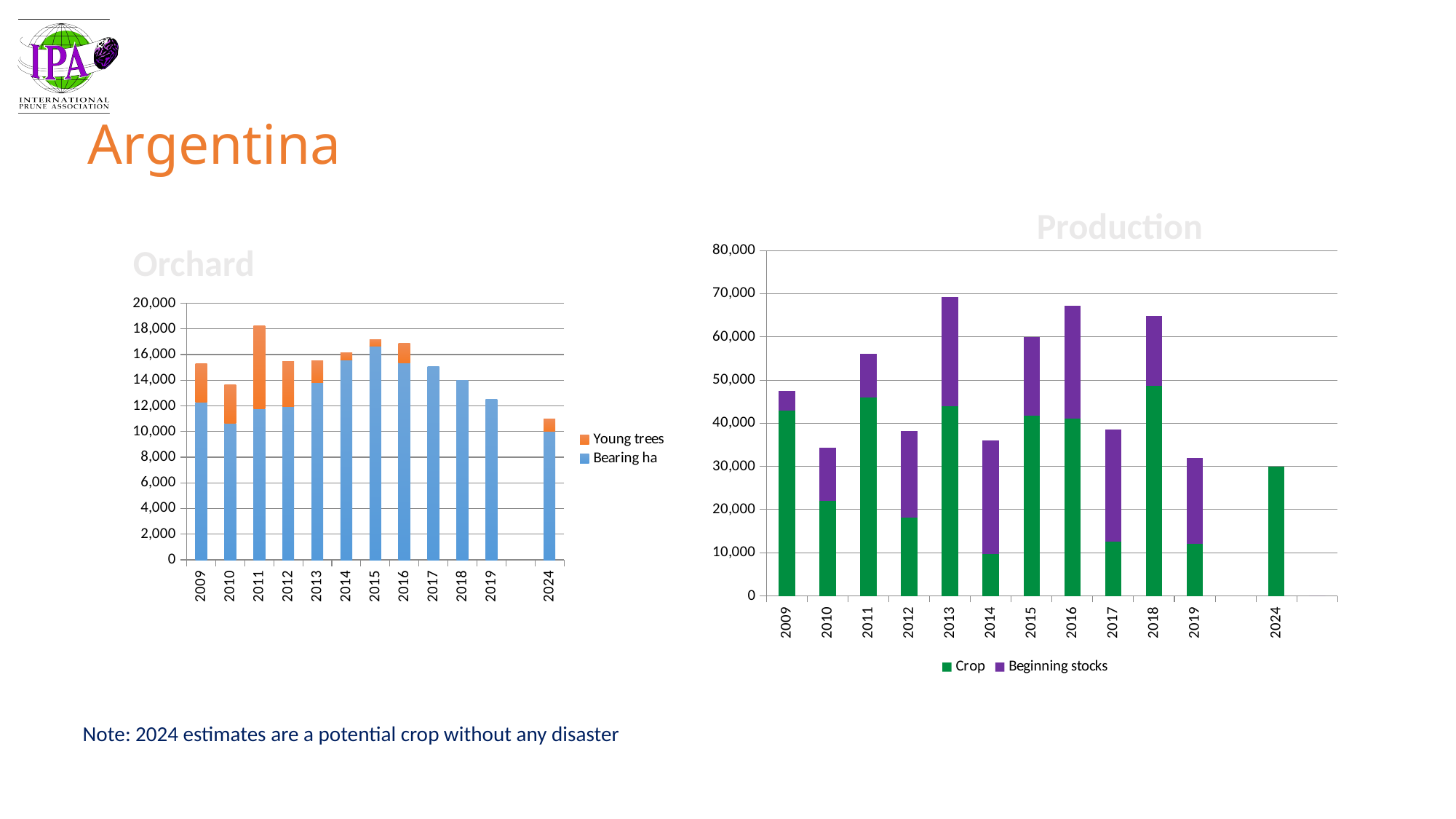
What kind of chart is the Orchard chart? stacked bar chart In the Production chart, which year has the largest Crop segment? 2018 In the Production chart, which year has the tallest total bar? 2013 In the Orchard chart, which year has the tallest total bar? 2011 How many series does the legend of the Production chart list? 2 In the Orchard chart, which year has the shortest total bar? 2024 In the Production chart, which year has the smallest Crop segment? 2014 In the Orchard chart, is the total bar for 2011 greater or less than 18,000? greater How many years are shown on the x axis of the Orchard chart? 12 In the Production chart, is the total bar for 2019 greater or less than 30,000? greater In the Production chart, which series is shown in purple? Beginning stocks